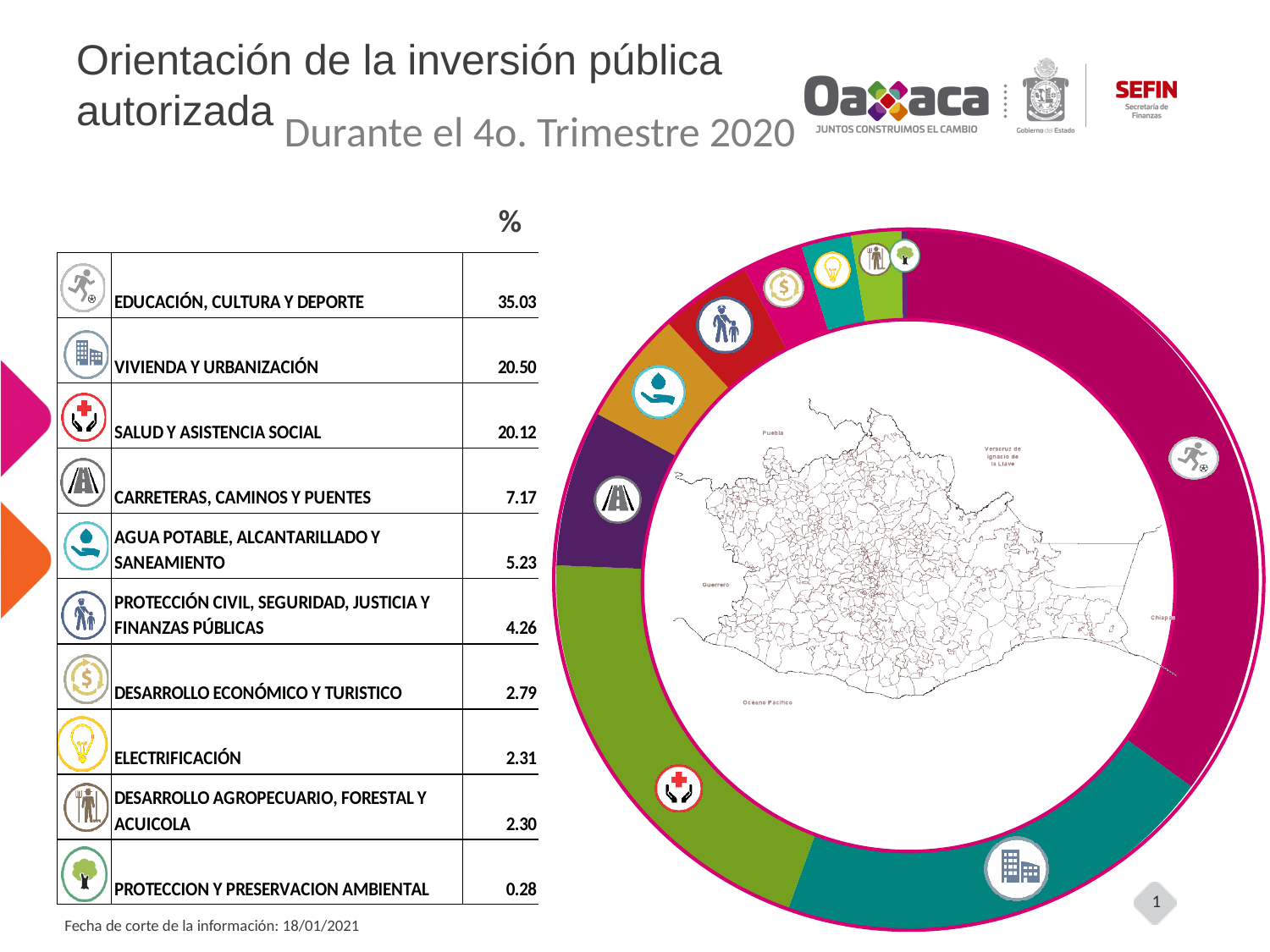
What is the percentage for Carreteras, Caminos y Puentes? 7.17 What share of the authorized public investment goes to Salud y Asistencia Social? 20.12 What is the percentage for Educación, Cultura y Deporte? 35.03 Which category has the highest percentage of authorized public investment? Educación, Cultura y Deporte What kind of chart is shown on the slide? Doughnut chart Which category has the lowest percentage of authorized public investment? Protección y Preservación Ambiental What is the percentage for Vivienda y Urbanización? 20.50 How many categories of public investment are listed in the table? 10 What is the percentage for Electrificación? 2.31 Which has a larger percentage, Carreteras, Caminos y Puentes or Agua Potable, Alcantarillado y Saneamiento? Carreteras, Caminos y Puentes What is the difference in percentage points between Educación, Cultura y Deporte and Vivienda y Urbanización? 14.53 What period does the chart cover, according to the subtitle? Durante el 4o. Trimestre 2020